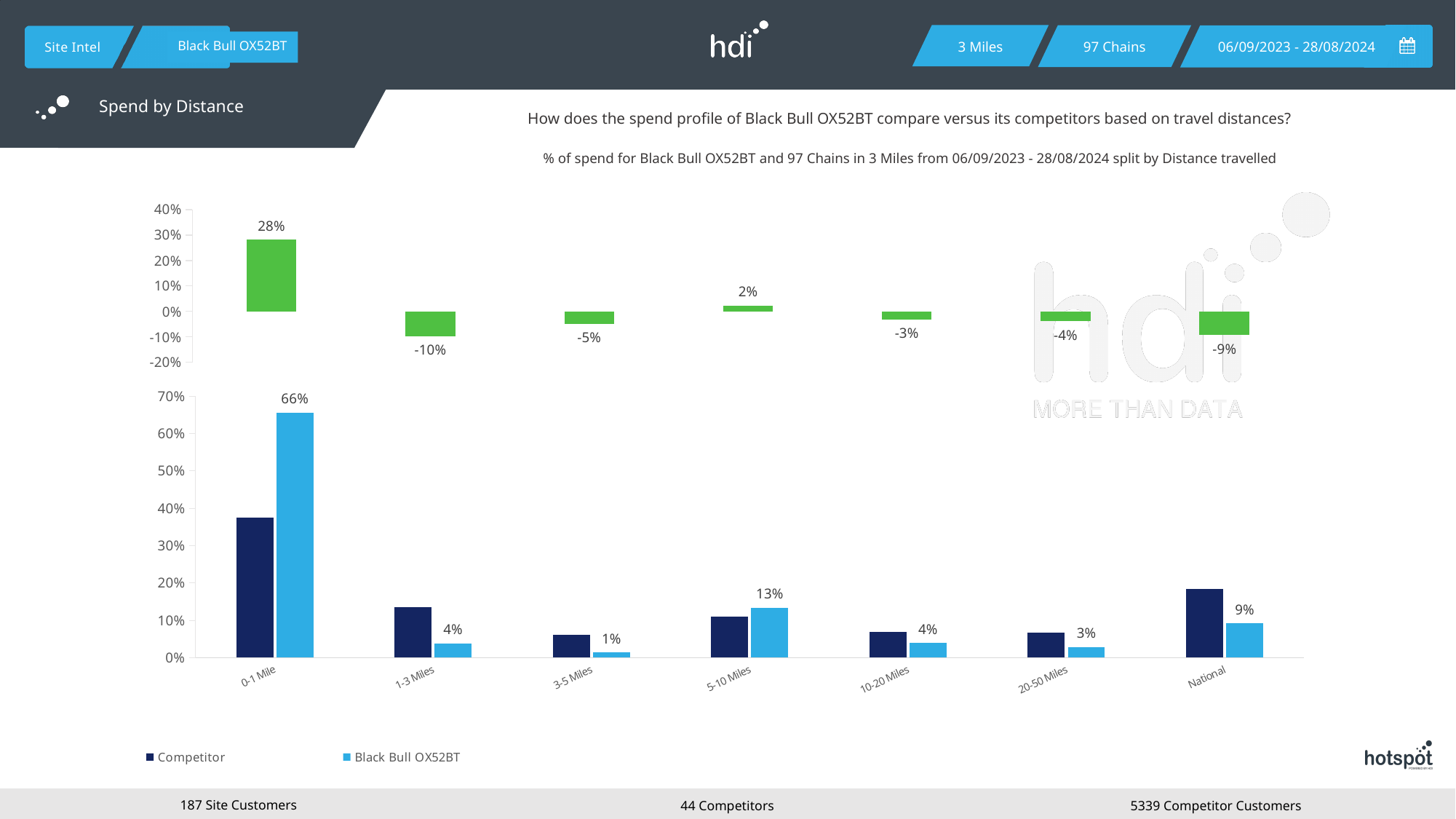
How many distance bands are shown on the x axis of the bottom chart? 7 In the bottom chart, what is the value for Black Bull OX52BT at 5-10 Miles? 13% In the bottom chart, at 0-1 Mile, which series has the larger value: Competitor or Black Bull OX52BT? Black Bull OX52BT In the bottom chart, what is the value for Black Bull OX52BT at 0-1 Mile? 66% In the bottom chart, which distance band has the lowest value for Black Bull OX52BT? 3-5 Miles In the top chart, what is the value shown for National? -9% In the top chart, which distance band has the highest value? 0-1 Mile In the top chart, what is the value shown for 1-3 Miles? -10% In the bottom chart, what is the difference between the Black Bull OX52BT values at 0-1 Mile and 5-10 Miles? 53% How many series does the legend of the bottom chart list? 2 In the bottom chart, is the Competitor value at 0-1 Mile greater or less than 30%? greater What type of chart is the bottom chart? Bar chart